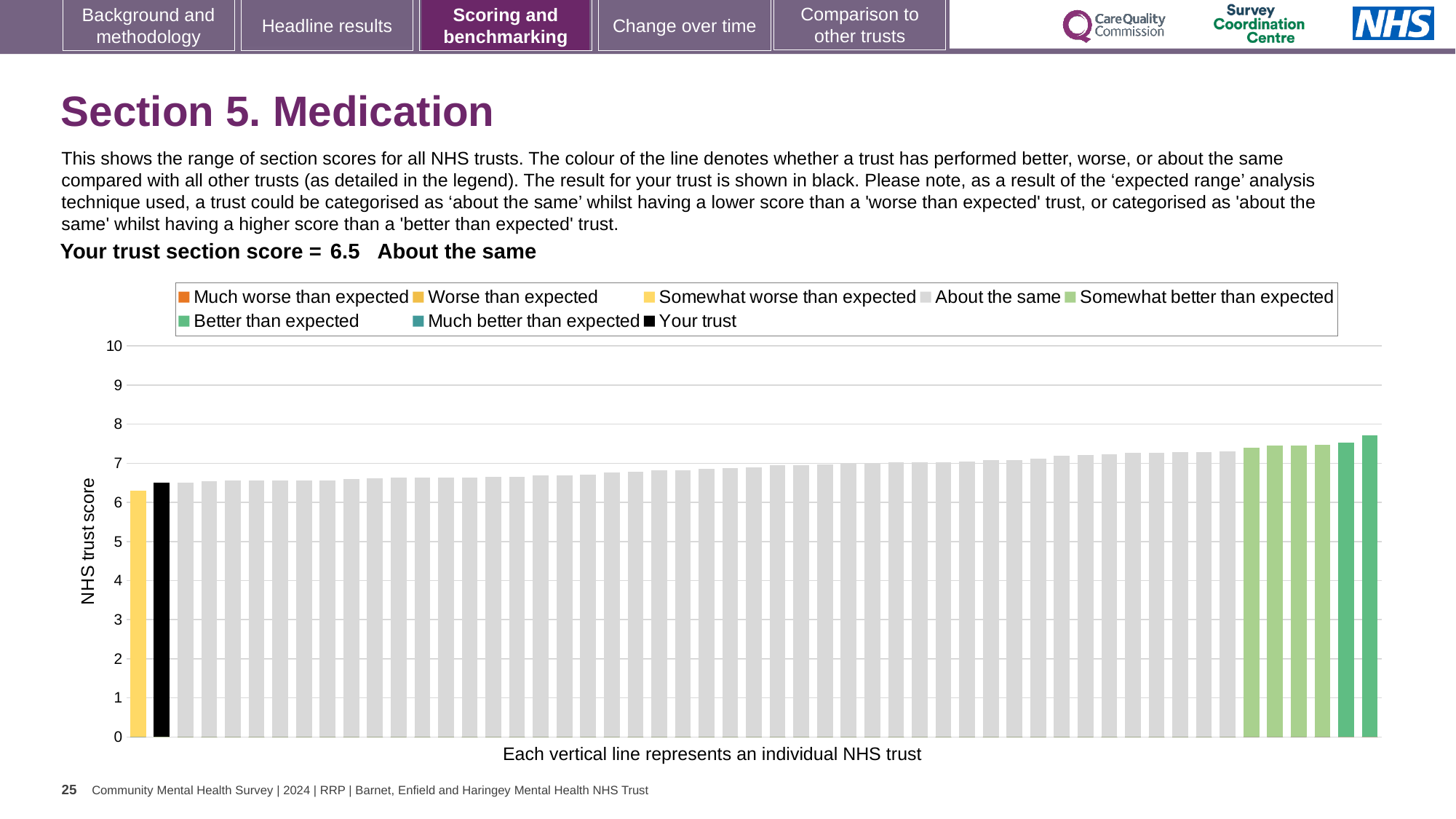
Is the value for your trust greater or less than 5? greater Is the value for the highest bar (rightmost trust) greater or less than 7? greater How many entries does the chart legend list? 8 What colour is the bar representing your trust? black What kind of chart is shown on the slide? bar chart Which is larger: the value for your trust (black bar) or the value for the yellow bar to its left? your trust Which is larger: the value for your trust (black bar) or the value for the rightmost bar? the rightmost bar Is the value for the lowest bar (leftmost trust) greater or less than 7? less What is the section score for your trust shown on the slide? 6.5 What is the label on the vertical axis of the chart? NHS trust score Do the bar values rise or fall from left to right along the x axis? rise